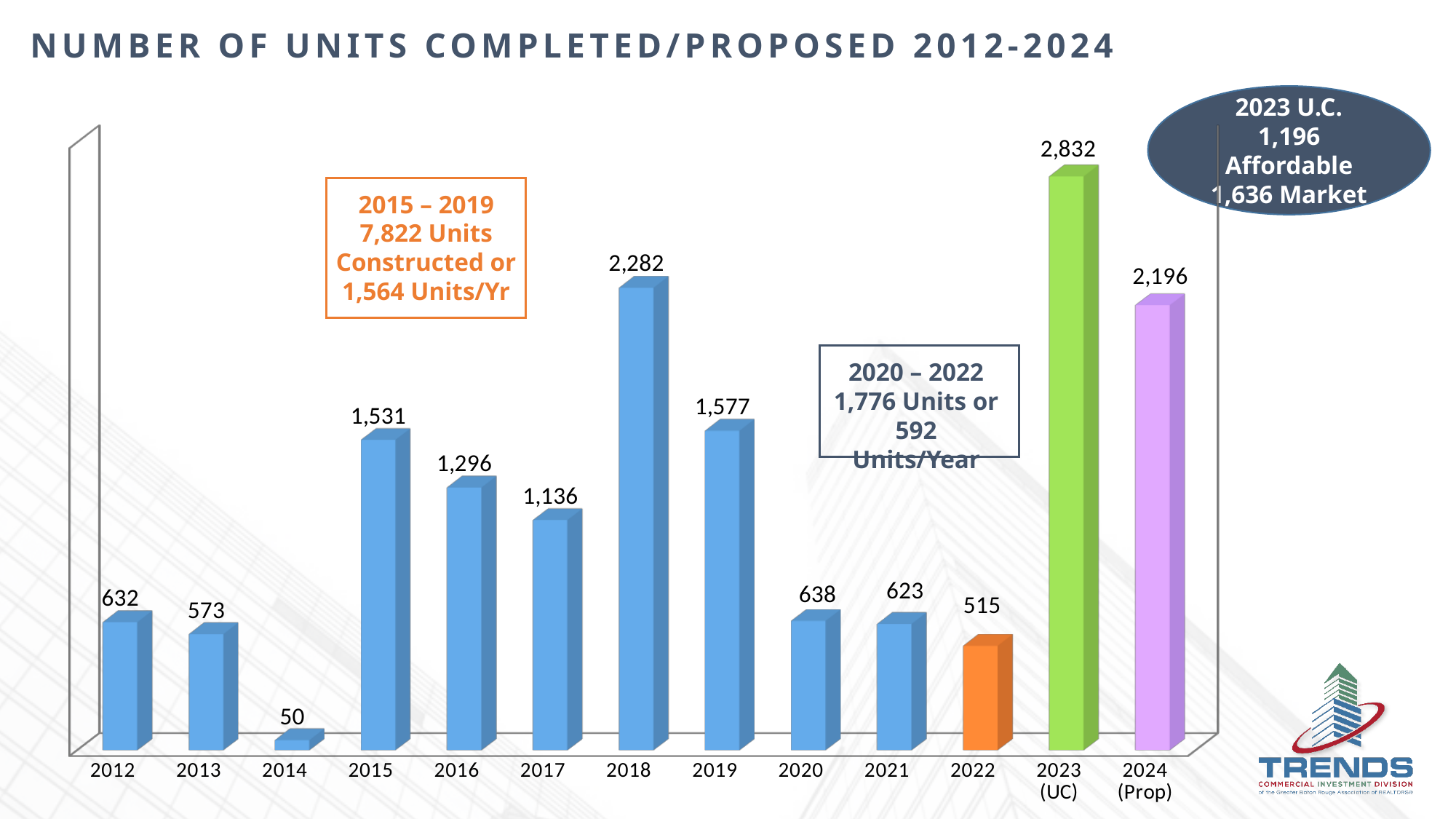
What kind of chart is shown on the slide? Bar chart What is the number of units for 2024 (Prop)? 2,196 What is the title of the chart? Number of Units Completed/Proposed 2012-2024 Which year has the lowest number of units? 2014 Which year has the highest number of units? 2023 (UC) What is the number of units for 2018? 2,282 What is the difference between the units for 2019 and 2017? 441 Which is larger, the value for 2015 or the value for 2016? 2015 What is the number of units for 2022? 515 What is the number of units for 2014? 50 How many years (categories) are shown on the x axis? 13 Do the values rise or fall from 2019 to 2022? Fall